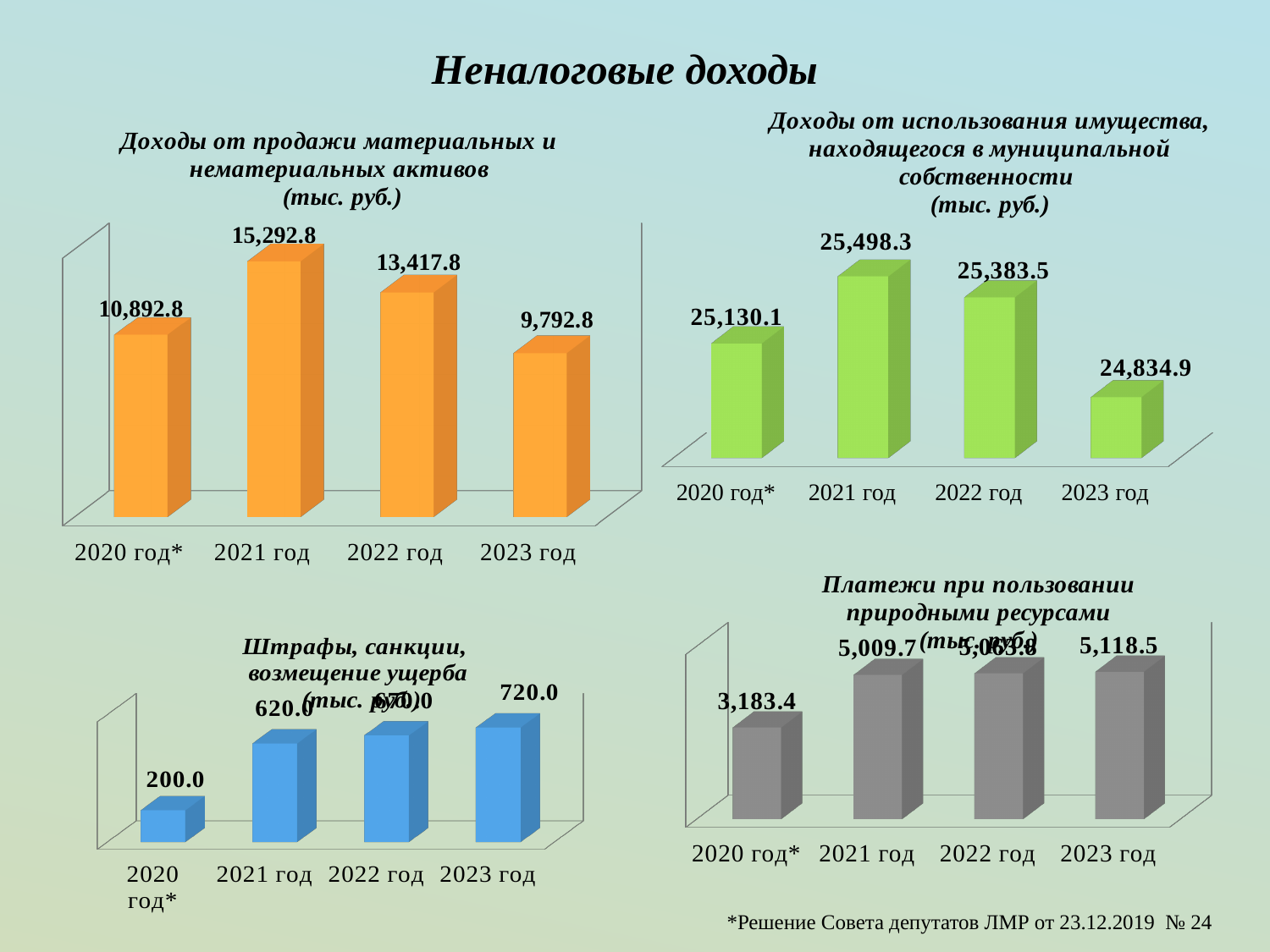
In the chart 'Платежи при пользовании природными ресурсами', what is the difference between the 2023 год and 2021 год values? 108.8 What type of chart is used for 'Штрафы, санкции, возмещение ущерба'? Bar chart In the chart 'Доходы от продажи материальных и нематериальных активов', what is the value for 2021 год? 15,292.8 In the chart 'Доходы от использования имущества, находящегося в муниципальной собственности', which year has the highest value? 2021 год In the chart 'Платежи при пользовании природными ресурсами', what is the value for 2020 год*? 3,183.4 In the chart 'Доходы от продажи материальных и нематериальных активов', which year has the lowest value? 2023 год In the chart 'Штрафы, санкции, возмещение ущерба', what is the value for 2020 год*? 200.0 In the chart 'Штрафы, санкции, возмещение ущерба', which is larger, the value for 2021 год or 2023 год? 2023 год In the chart 'Доходы от использования имущества, находящегося в муниципальной собственности', what is the difference between the 2021 год and 2020 год* values? 368.2 How many bars are shown in the chart 'Платежи при пользовании природными ресурсами'? 4 In the chart 'Доходы от продажи материальных и нематериальных активов', what is the difference between the 2021 год and 2022 год values? 1,875.0 In the chart 'Доходы от использования имущества, находящегося в муниципальной собственности', what is the value for 2023 год? 24,834.9